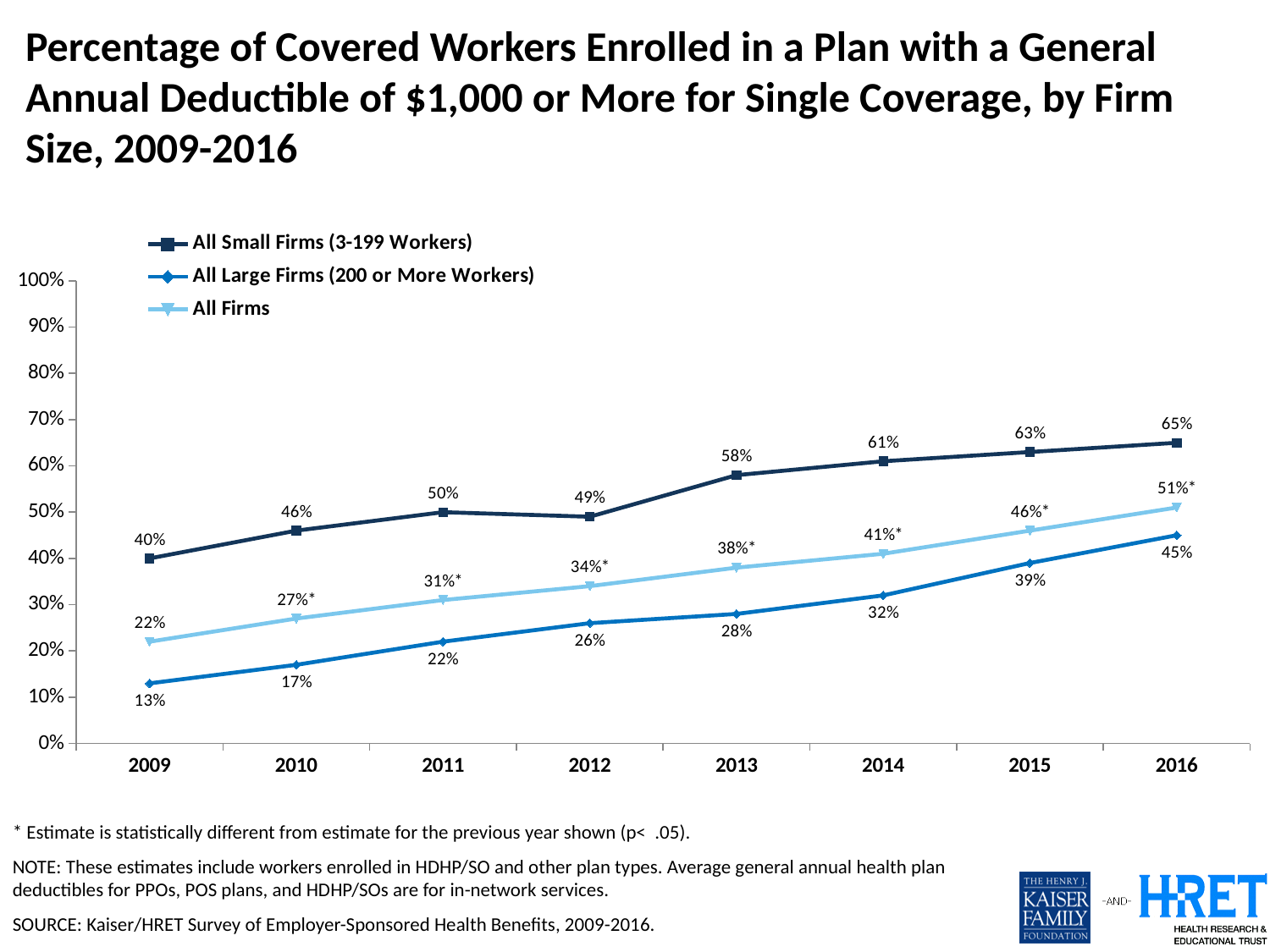
How many years are shown on the x axis? 8 Which series has the larger value in 2014: All Small Firms (3-199 Workers) or All Firms? All Small Firms (3-199 Workers) Is the value for All Large Firms (200 or More Workers) in 2015 greater or less than 30%? greater How many series does the legend list? 3 Does the value for All Firms rise or fall from 2009 to 2016? Rise In which year is the value for All Small Firms (3-199 Workers) lowest? 2009 What is the value for All Firms in 2013? 38%* What is the difference between the All Small Firms and All Large Firms values in 2012? 23 percentage points What kind of chart is shown on the slide? Line chart What percentage of covered workers in All Small Firms (3-199 Workers) were enrolled in a plan with a deductible of $1,000 or more in 2016? 65% In which year is the value for All Large Firms (200 or More Workers) highest? 2016 What is the value for All Large Firms (200 or More Workers) in 2009? 13%